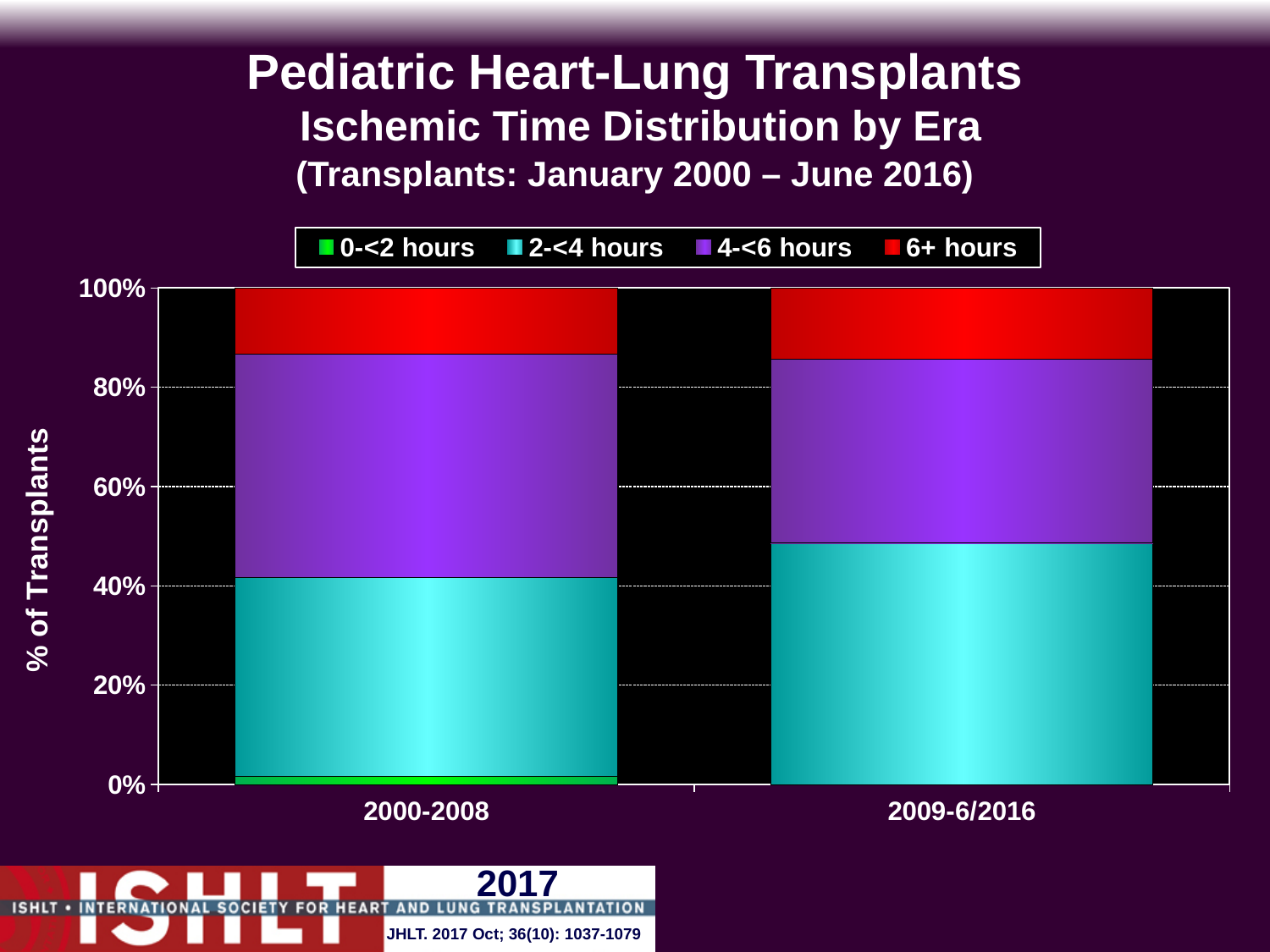
What is the label of the y axis? % of Transplants Which era has the larger share of 4-<6 hours, 2000-2008 or 2009-6/2016? 2000-2008 Which ischemic time category has the largest share in 2009-6/2016? 2-<4 hours Is the share of 2-<4 hours in 2009-6/2016 greater or less than 40%? greater Is the share of 0-<2 hours in 2000-2008 greater or less than 20%? less What kind of chart is shown on the slide? Stacked bar chart What is the total of the stacked bar for 2000-2008? 100% Which era has the larger share of 2-<4 hours, 2000-2008 or 2009-6/2016? 2009-6/2016 Which ischemic time category has the smallest share in 2000-2008? 0-<2 hours Is the share of 6+ hours in 2000-2008 greater or less than 20%? less How many eras (categories) are shown on the x axis? 2 How many series does the legend list? 4